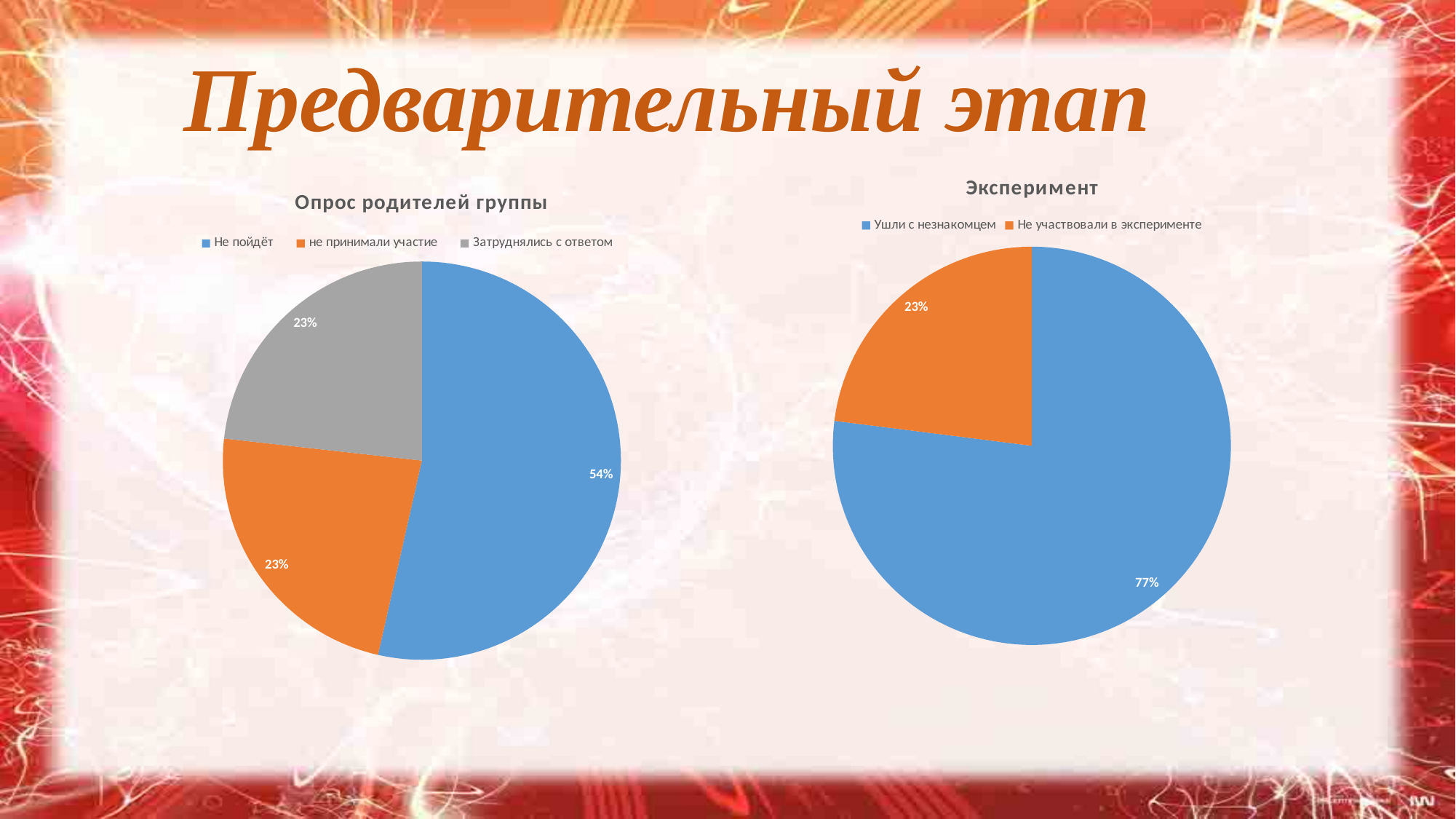
In the chart titled "Эксперимент", how many entries does the legend list? 2 In the chart titled "Эксперимент", what share is labelled for "Не участвовали в эксперименте"? 23% In the chart titled "Эксперимент", what share is labelled for "Ушли с незнакомцем"? 77% In the chart titled "Опрос родителей группы", how many slices does the pie have? 3 In the chart titled "Эксперимент", what is the difference in percentage points between the two slices? 54 In the chart titled "Опрос родителей группы", what share is labelled for the "Затруднялись с ответом" slice? 23% In the chart titled "Опрос родителей группы", what share is labelled for the "Не пойдёт" slice? 54% In the chart titled "Опрос родителей группы", what is the difference in percentage points between "Не пойдёт" and "не принимали участие"? 31 In the chart titled "Эксперимент", which category has the smaller slice? Не участвовали в эксперименте In the chart titled "Опрос родителей группы", what colour is the "Затруднялись с ответом" slice? Grey In the chart titled "Опрос родителей группы", which category has the largest slice? Не пойдёт What type of chart is the one titled "Эксперимент"? Pie chart